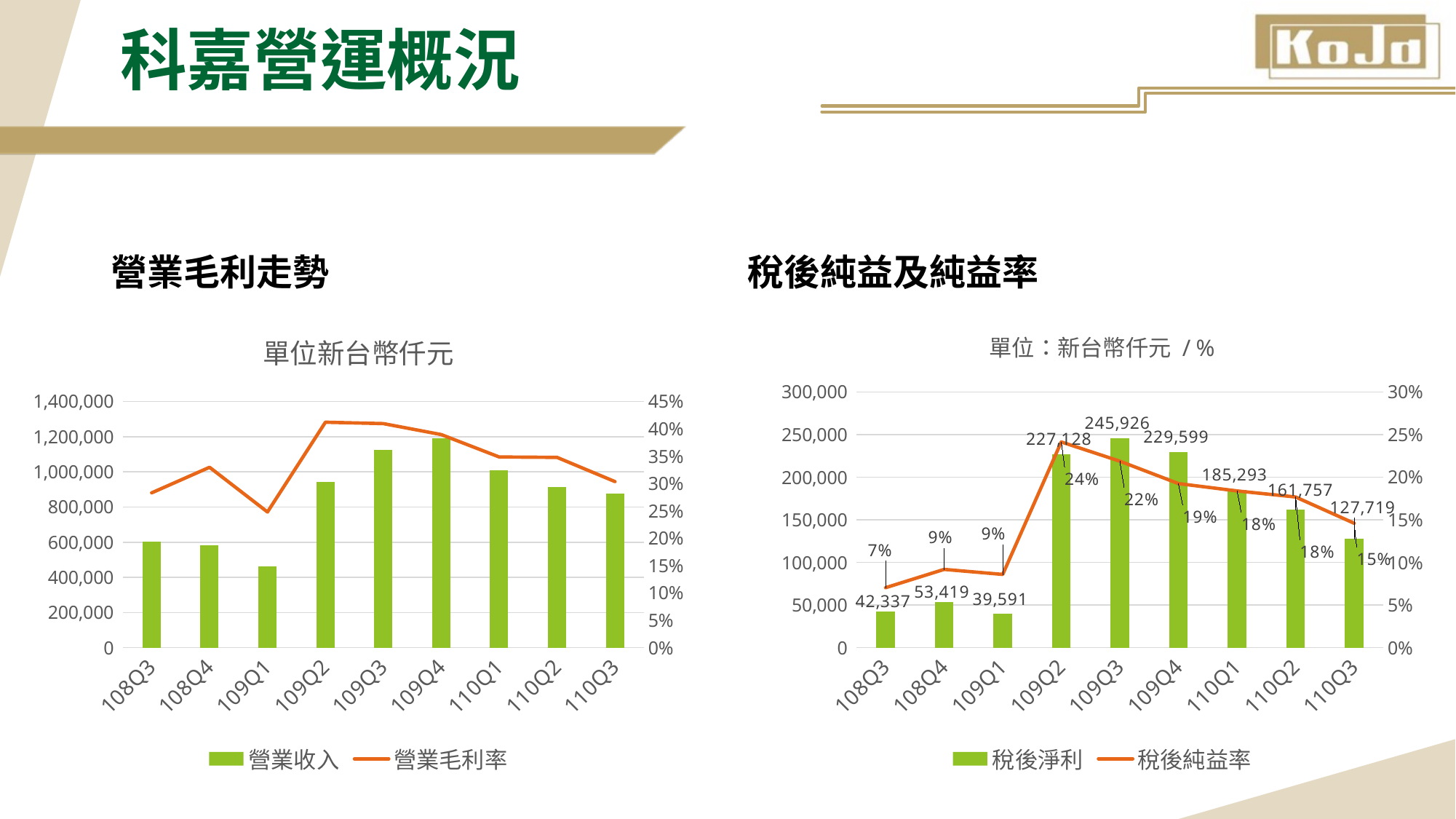
In the 稅後純益及純益率 chart, what is the 稅後淨利 value for 109Q3? 245,926 In the 稅後純益及純益率 chart, which quarter has the lowest 稅後淨利? 109Q1 In the 稅後純益及純益率 chart, what is the difference in 稅後淨利 between 109Q3 and 110Q3? 118,207 In the 營業毛利走勢 chart, is the 營業收入 value for 109Q4 greater or less than 1,000,000? greater In the 營業毛利走勢 chart, how many series does the legend list? 2 In the 營業毛利走勢 chart, is the 營業收入 value for 109Q1 greater or less than 600,000? less In the 稅後純益及純益率 chart, how many quarters are shown on the x axis? 9 In the 稅後純益及純益率 chart, which quarter has the highest 稅後淨利? 109Q3 What type of chart is the 營業毛利走勢 chart? Combined bar and line chart In the 稅後純益及純益率 chart, which is larger, the 稅後淨利 for 109Q4 or for 110Q1? 109Q4 In the 稅後純益及純益率 chart, what is the 稅後純益率 for 109Q2? 24% In the 營業毛利走勢 chart, which quarter has the highest 營業收入 bar? 109Q4